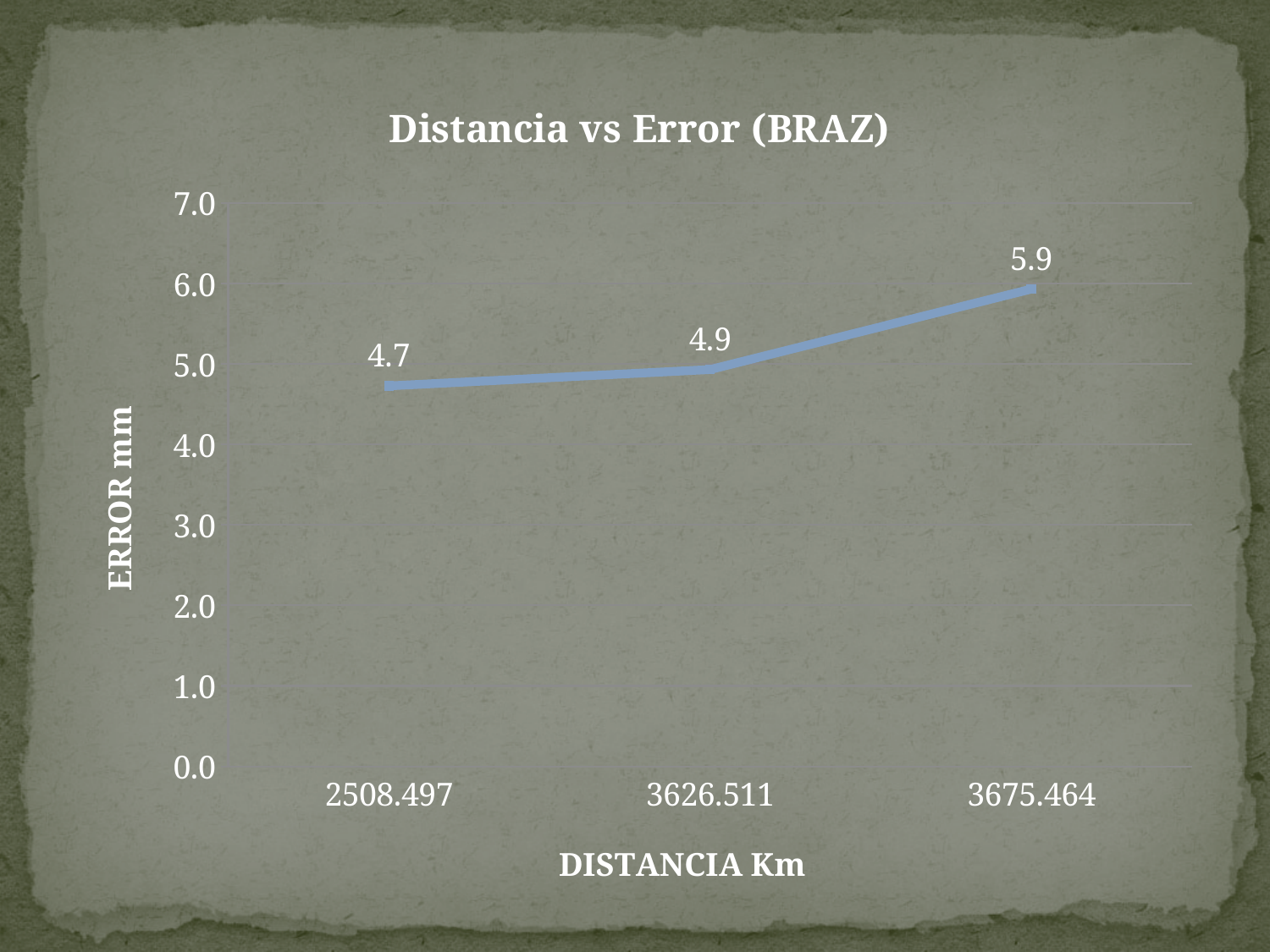
Does the error rise or fall as distance increases along the x axis? rise What is the error value at a distance of 3675.464 km? 5.9 At which distance is the error lowest? 2508.497 At which distance is the error highest? 3675.464 Which has a larger error: the distance 3626.511 km or 3675.464 km? 3675.464 What is the error value at a distance of 3626.511 km? 4.9 How many data points are plotted on the chart? 3 Is the error at 3675.464 km greater or less than 5.0? greater What is the error value at a distance of 2508.497 km? 4.7 What is the difference in error between the distances 3675.464 km and 2508.497 km? 1.2 What kind of chart is shown on the slide? line chart What is the title of the chart? Distancia vs Error (BRAZ)